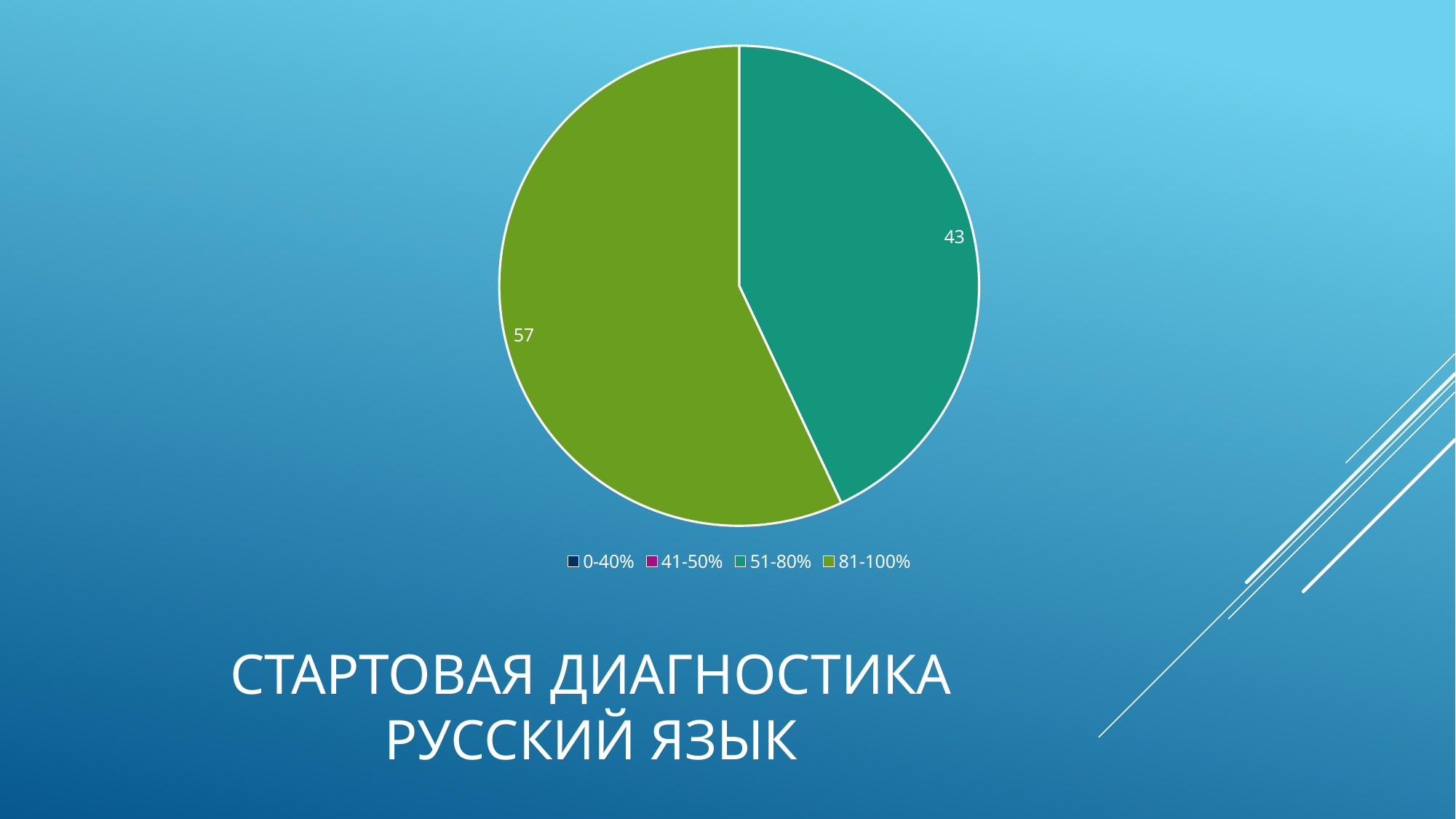
What kind of chart is shown on the slide? pie chart What is the value shown for the 81-100% slice of the pie chart? 57 What share of the pie does the 81-100% slice represent? 57% What is the title text shown below the pie chart? СТАРТОВАЯ ДИАГНОСТИКА РУССКИЙ ЯЗЫК What is the difference between the 81-100% value and the 51-80% value in the pie chart? 14 How many slices with data labels are visible in the pie chart? 2 What share of the pie does the 51-80% slice represent? 43% What is the total of the two labelled slices in the pie chart? 100 What is the value shown for the 51-80% slice of the pie chart? 43 Which is larger in the pie chart: the 51-80% slice or the 81-100% slice? 81-100% Which category has the largest slice in the pie chart? 81-100% How many entries does the legend of the pie chart list? 4